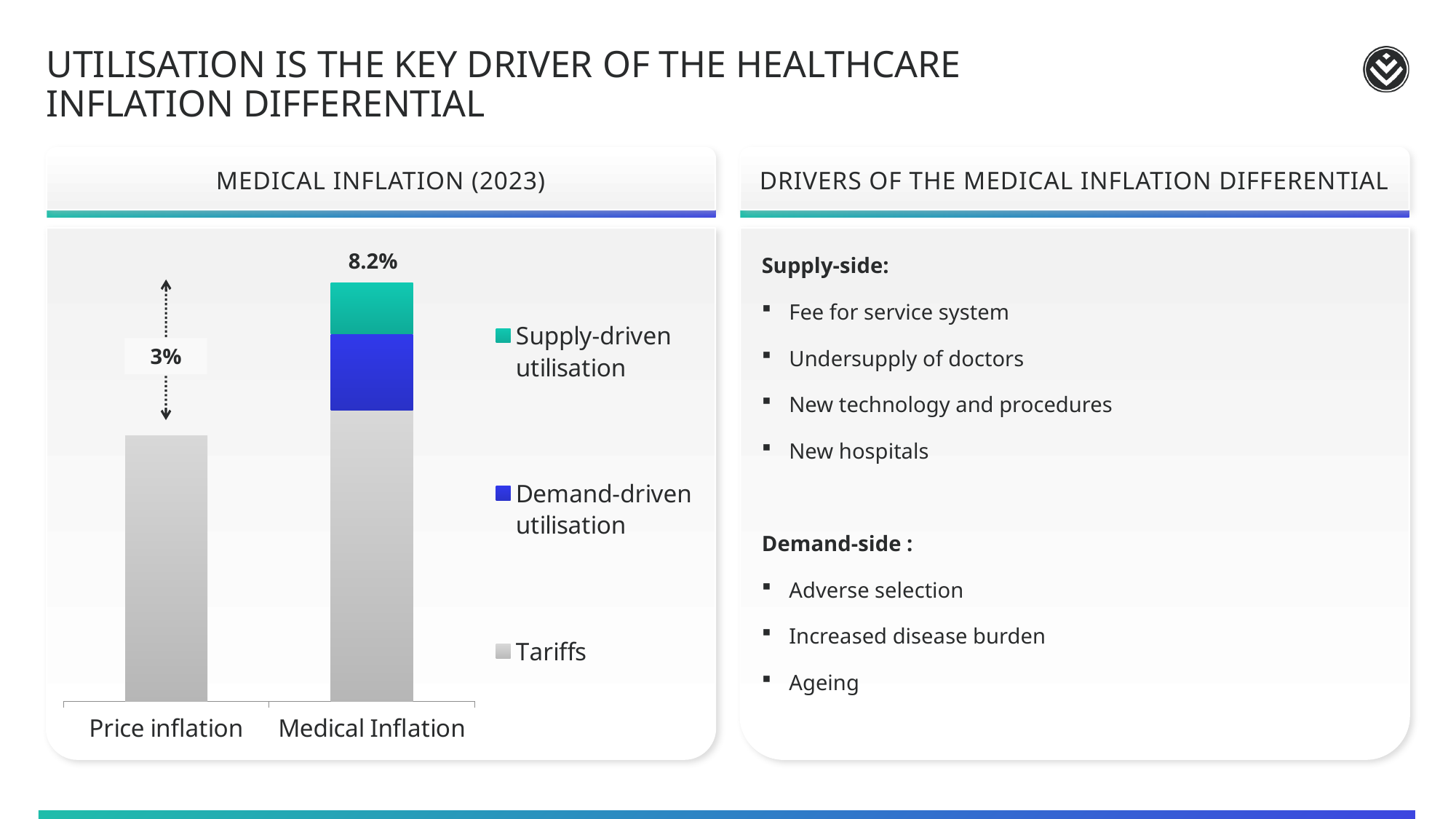
How many categories are shown on the x axis of the Medical Inflation (2023) chart? 2 Which category has the lowest total in the Medical Inflation (2023) chart? Price inflation Which series forms the bottom segment of the Medical Inflation stacked bar? Tariffs What value is labelled on the dotted arrow showing the gap between the Price inflation bar and the Medical Inflation bar? 3% Which single series makes up the entire Price inflation bar? Tariffs What is the total value labelled on the Medical Inflation bar? 8.2% Which category has the highest total in the Medical Inflation (2023) chart? Medical Inflation Which series is shown in teal/green in the Medical Inflation (2023) chart legend? Supply-driven utilisation What kind of chart is shown under "MEDICAL INFLATION (2023)"? Stacked bar chart How many series does the legend of the Medical Inflation (2023) chart list? 3 Which category has the taller bar, Price inflation or Medical Inflation? Medical Inflation